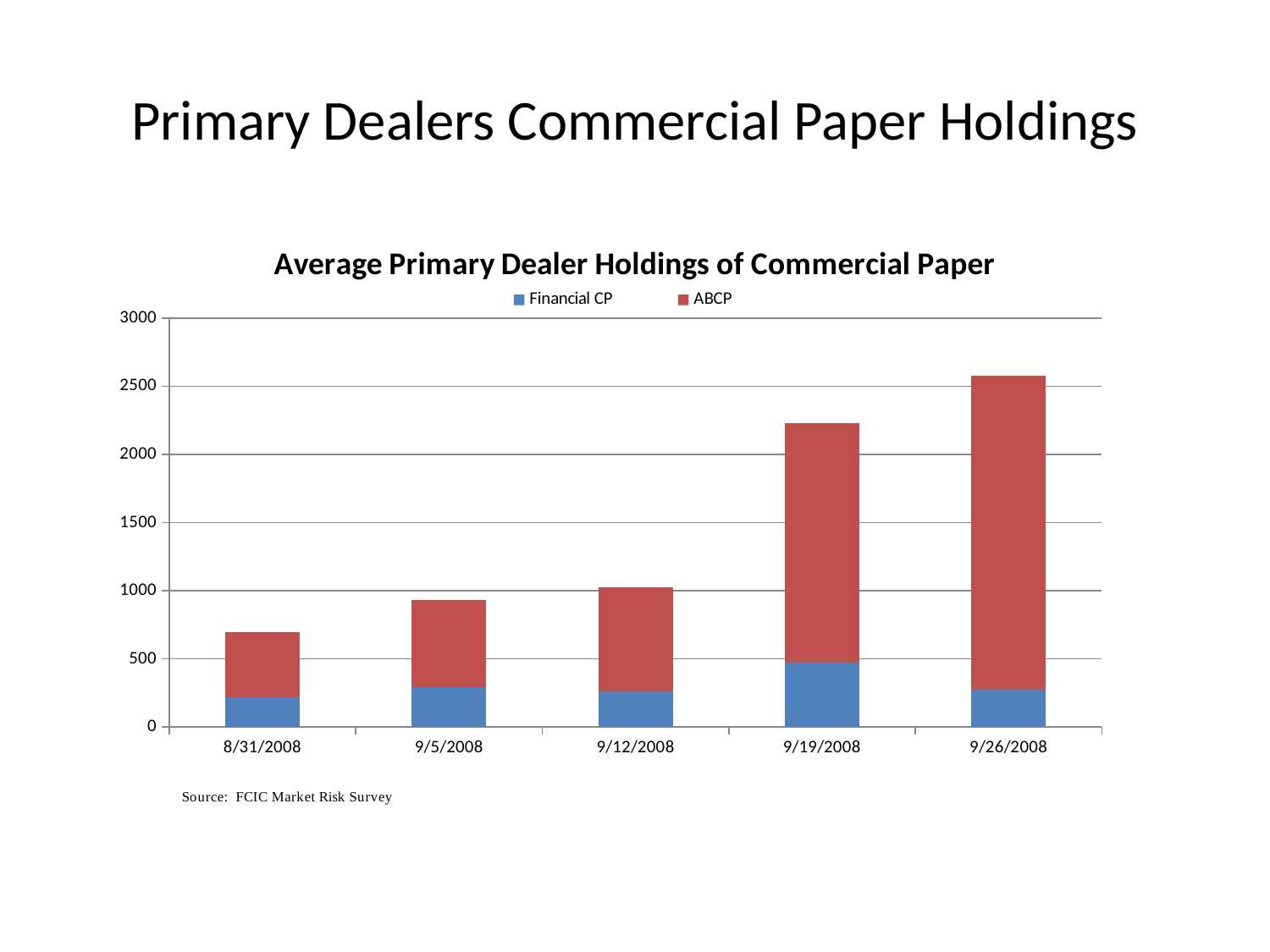
How many series does the chart's legend list? 2 What kind of chart is shown on the slide? Stacked bar chart How many dates are shown on the x axis of the chart? 5 Which date has the tallest stacked bar (highest total holdings)? 9/26/2008 What is the title of the chart? Average Primary Dealer Holdings of Commercial Paper Is the total stacked bar for 9/5/2008 greater or less than 1000? less Is the Financial CP value for 8/31/2008 greater or less than 500? less Which has the larger total holdings, 9/12/2008 or 9/19/2008? 9/19/2008 Do the total holdings generally rise or fall from 8/31/2008 to 9/26/2008? Rise Is the total stacked bar for 9/19/2008 greater or less than 2000? greater Which date has the largest Financial CP segment? 9/19/2008 Which date has the shortest stacked bar (lowest total holdings)? 8/31/2008